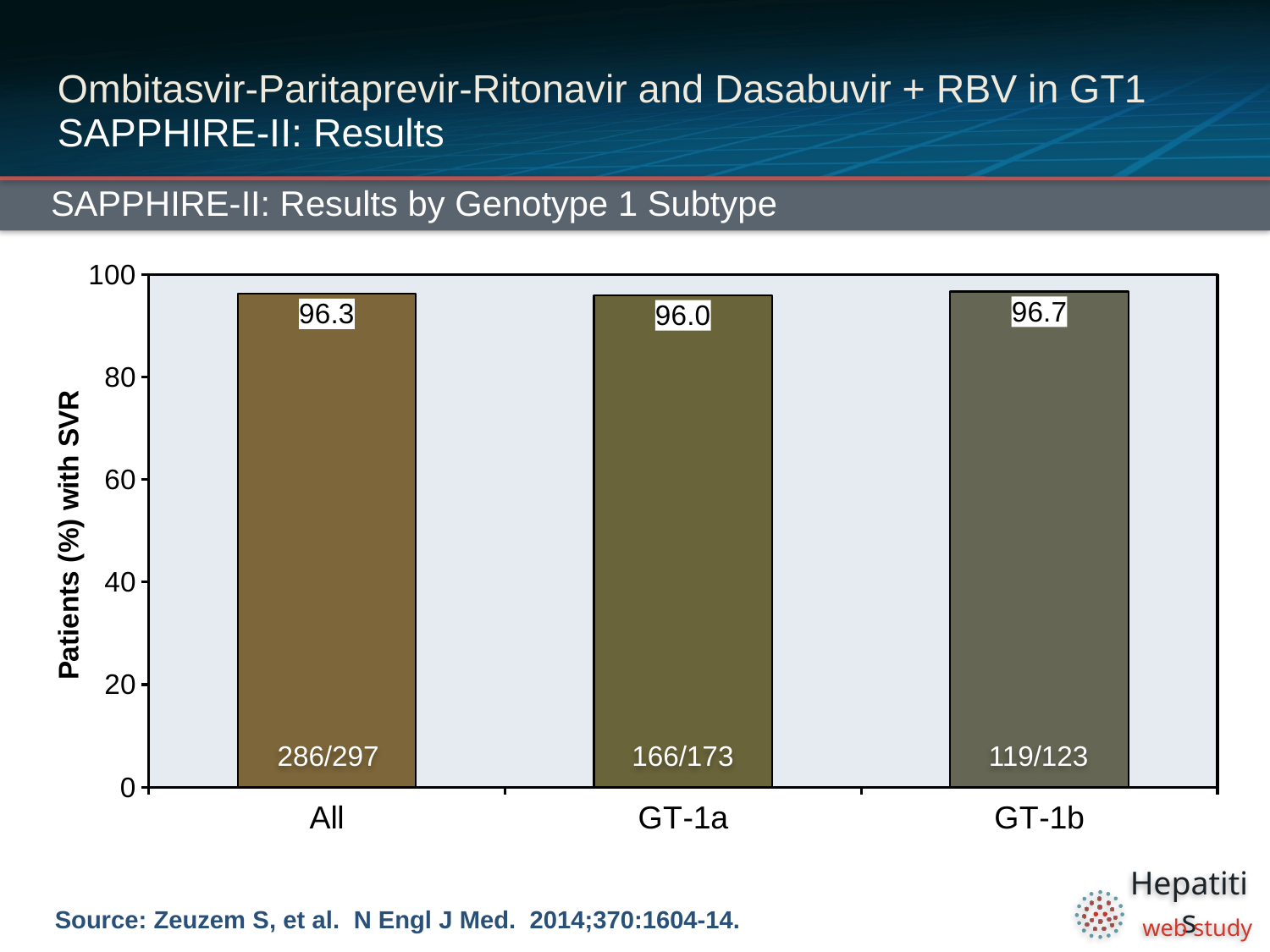
What fraction of patients achieved SVR in the All group, as printed on the bar? 286/297 What is the label of the y axis? Patients (%) with SVR Which subtype group has the highest SVR rate according to the data labels? GT-1b What is the SVR rate (%) for GT-1a? 96.0 Which group has the lowest SVR rate according to the data labels? GT-1a What is the SVR rate (%) for GT-1b? 96.7 What type of chart is shown on the slide? Bar chart What is the SVR rate (%) for the All group? 96.3 What fraction of patients achieved SVR in the GT-1a group, as printed on the bar? 166/173 How many groups are shown on the x axis? 3 Is the SVR rate for the All group greater or less than 80? greater What is the difference in SVR rate between GT-1b and GT-1a? 0.7